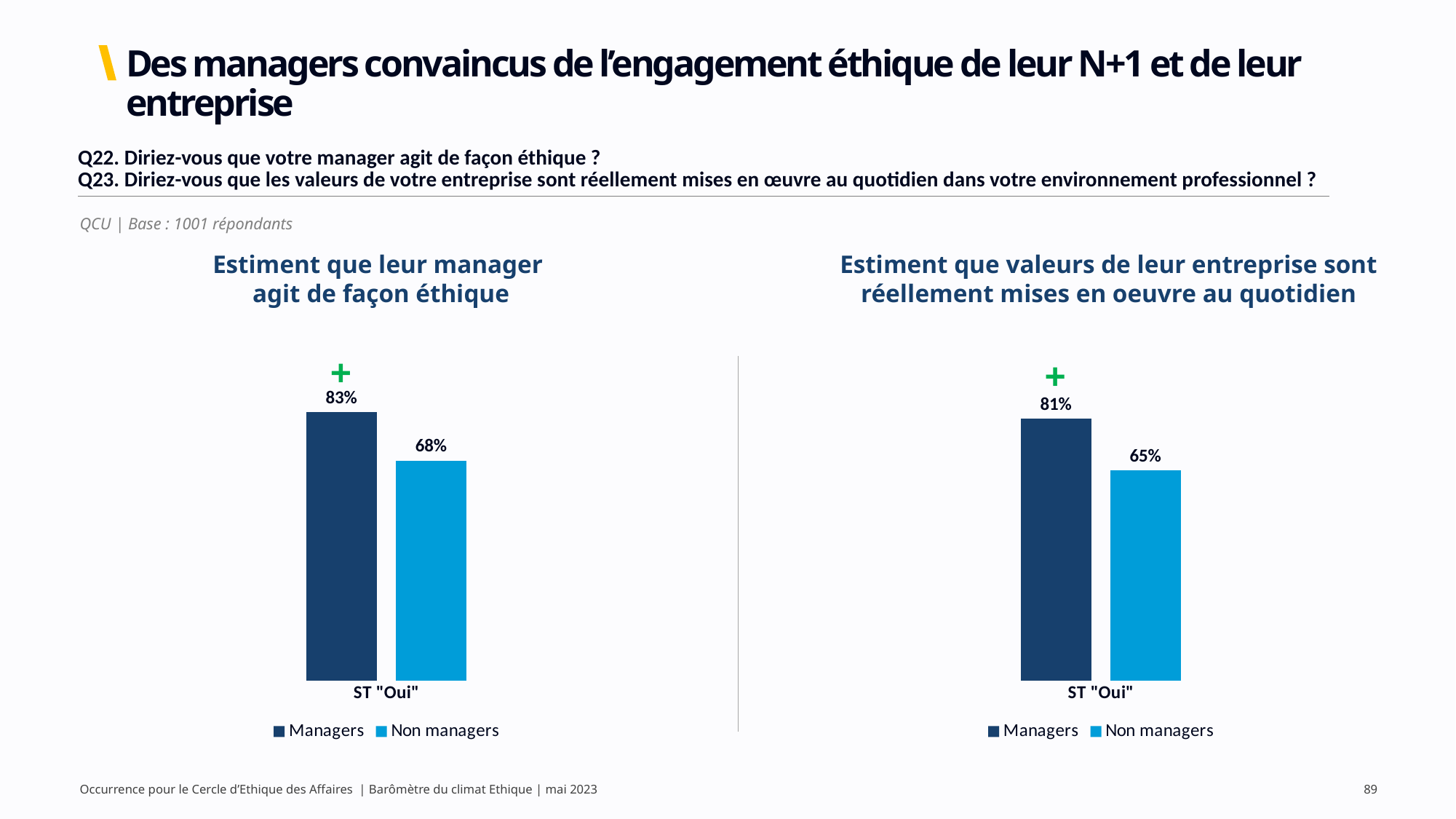
In the right chart, which series has the lower value? Non managers In the right chart (Estiment que valeurs de leur entreprise sont réellement mises en oeuvre au quotidien), what is the value for Non managers? 65% In the left chart (Estiment que leur manager agit de façon éthique), what is the value for Managers? 83% What is the category label shown on the x axis of the left chart? ST "Oui" How many series does the legend of the left chart list? 2 In the left chart, which series has the higher value, Managers or Non managers? Managers In the left chart (Estiment que leur manager agit de façon éthique), what is the value for Non managers? 68% In the right chart, what is the difference between the Managers and Non managers values? 16 percentage points What kind of chart is the right chart? Bar chart In the right chart, which colour represents Non managers? Light blue In the left chart, what is the difference between the Managers and Non managers values? 15 percentage points In the right chart (Estiment que valeurs de leur entreprise sont réellement mises en oeuvre au quotidien), what is the value for Managers? 81%